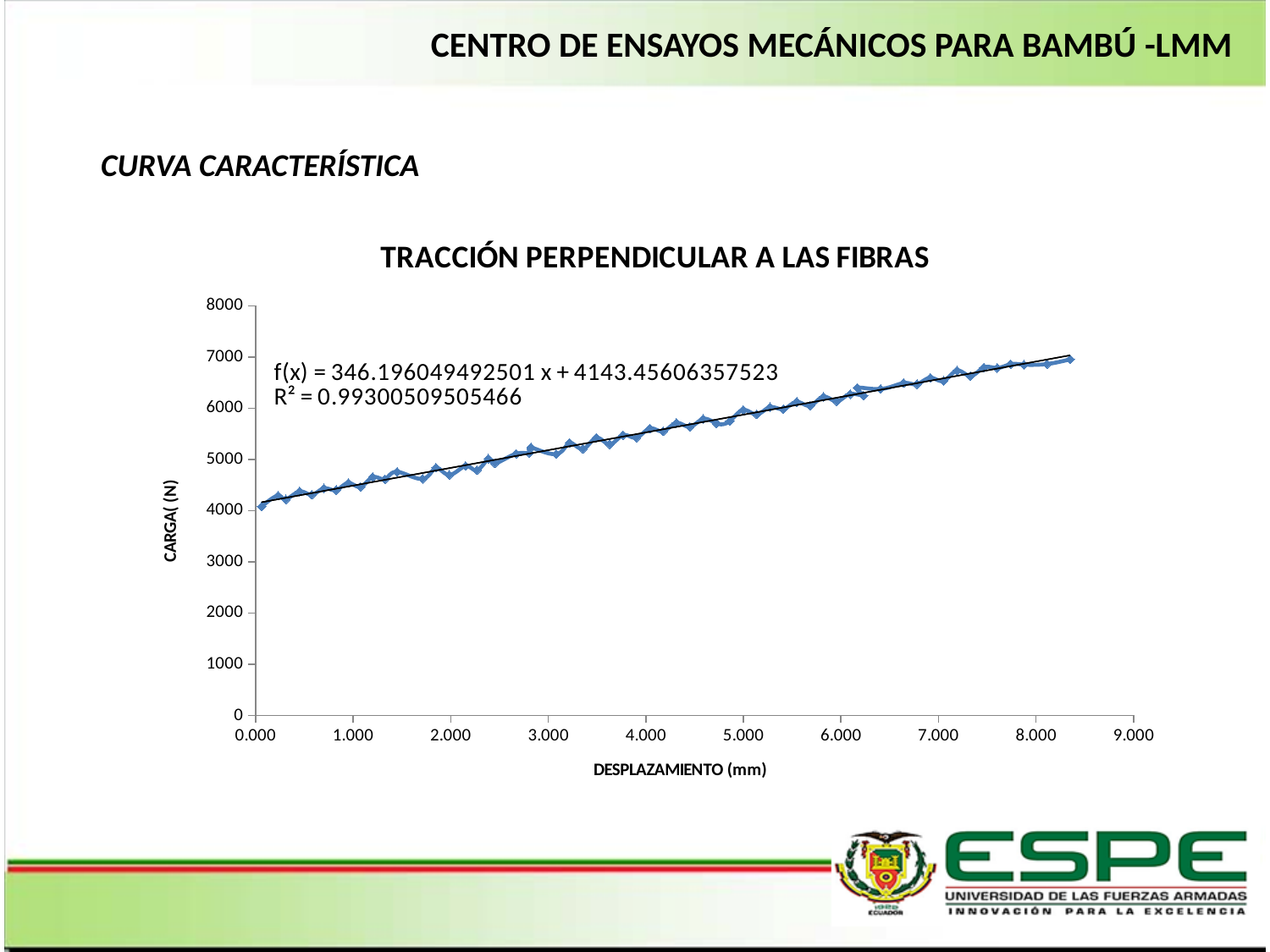
Is the load at a displacement of 2.000 mm greater or less than 5000 N? less What kind of chart is shown on the slide? Scatter chart with a linear trendline What is the title of the chart? TRACCIÓN PERPENDICULAR A LAS FIBRAS Is the load at a displacement of 4.000 mm greater or less than 5000 N? greater Is the load at a displacement of 6.000 mm greater or less than 6000 N? greater What is the intercept of the trendline shown on the chart? 4143.45606357523 What is the slope of the trendline shown on the chart? 346.196049492501 Does the load (CARGA) rise or fall as displacement (DESPLAZAMIENTO) increases along the x axis? Rise What is the trendline equation printed on the chart? f(x) = 346.196049492501 x + 4143.45606357523 What R² value is printed on the chart? 0.99300509505466